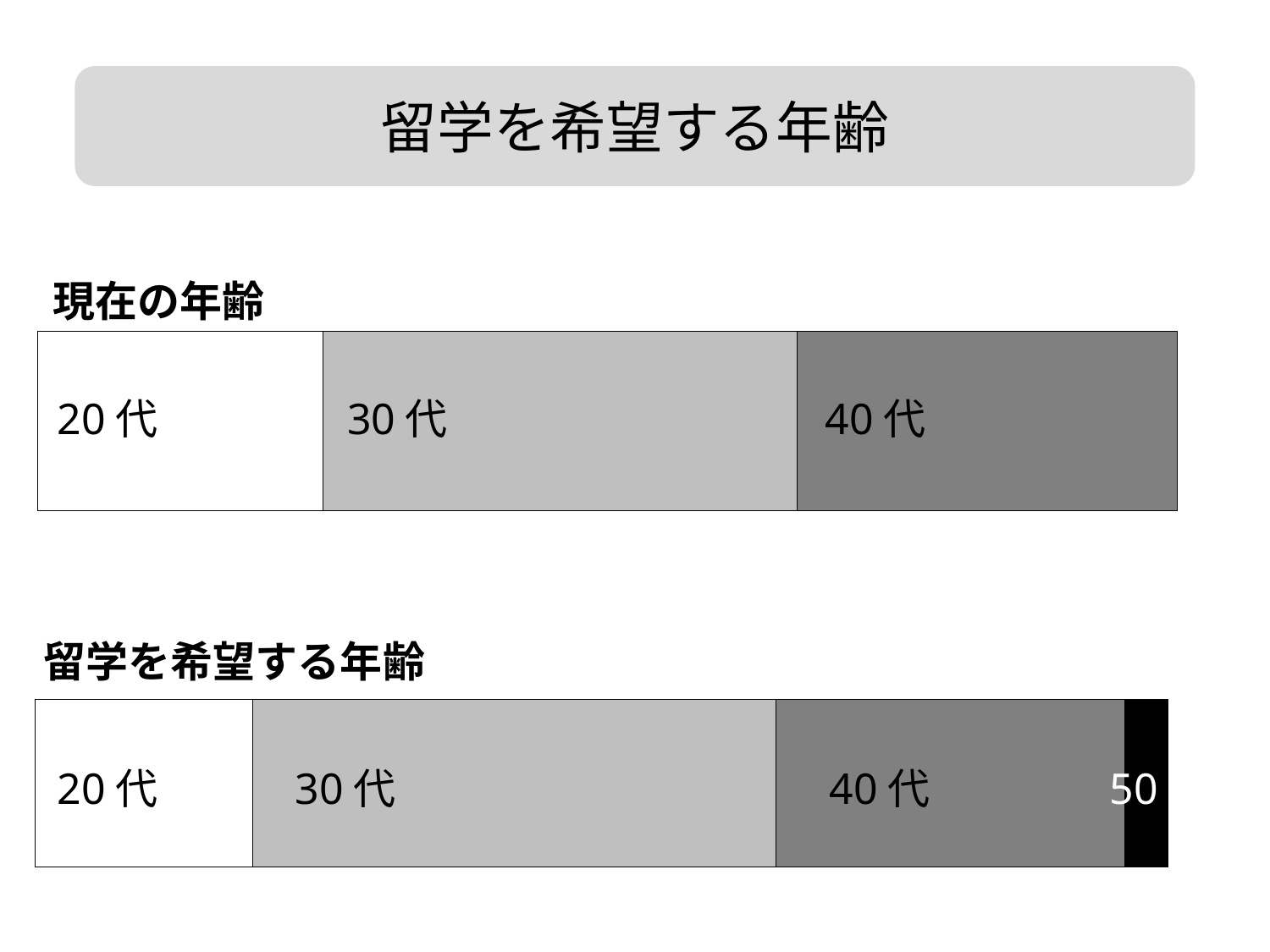
In the 留学を希望する年齢 chart, which segment is the smallest? 50 In the 現在の年齢 chart, which age group has the largest segment? 30代 In the 現在の年齢 chart, which age group has the smallest segment? 20代 In the 留学を希望する年齢 chart, which segment is larger, 20代 or 40代? 40代 In the 現在の年齢 chart, how many age-group segments are shown? 3 What is the title of the slide? 留学を希望する年齢 What kind of chart is used for 現在の年齢? Stacked bar chart In the 現在の年齢 chart, which segment is larger, 30代 or 40代? 30代 In the 留学を希望する年齢 chart, which age group has the largest segment? 30代 In the 留学を希望する年齢 chart, how many age-group segments are shown? 4 Which age-group segment appears in the 留学を希望する年齢 chart but not in the 現在の年齢 chart? 50